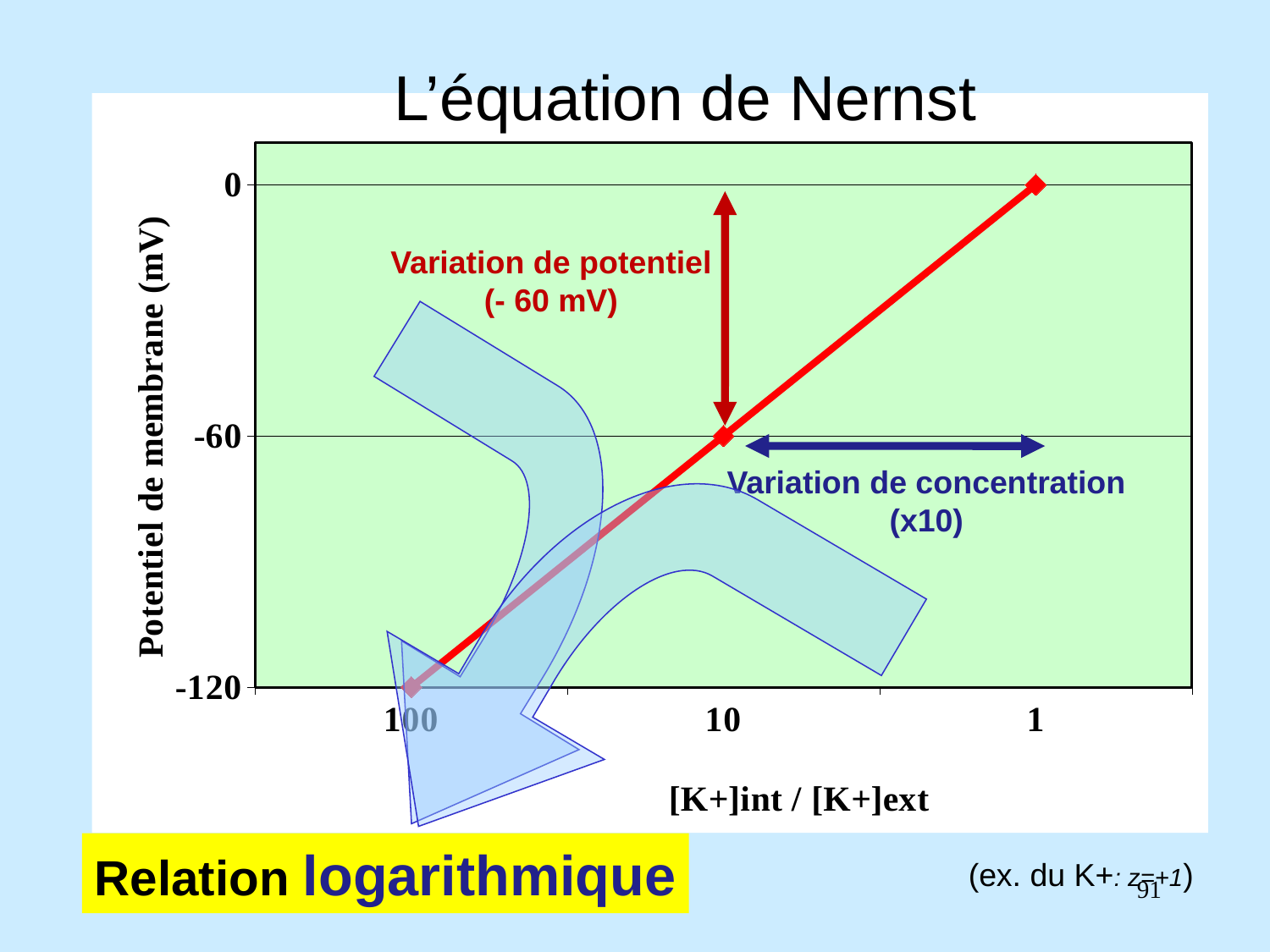
What is the difference in membrane potential between the ratio 10 and the ratio 100? 60 What is the label of the y axis? Potentiel de membrane (mV) At which [K+]int / [K+]ext ratio is the membrane potential highest? 1 Does the membrane potential rise or fall moving from left to right along the x axis? rise What is the membrane potential when [K+]int / [K+]ext is 100? -120 Which has a higher membrane potential: the ratio 10 or the ratio 100? 10 What is the membrane potential when [K+]int / [K+]ext is 10? -60 How many data points are plotted on the line? 3 What is the membrane potential when [K+]int / [K+]ext is 1? 0 What is the label of the x axis? [K+]int / [K+]ext What kind of chart is shown on the slide? line chart At which [K+]int / [K+]ext ratio is the membrane potential lowest? 100